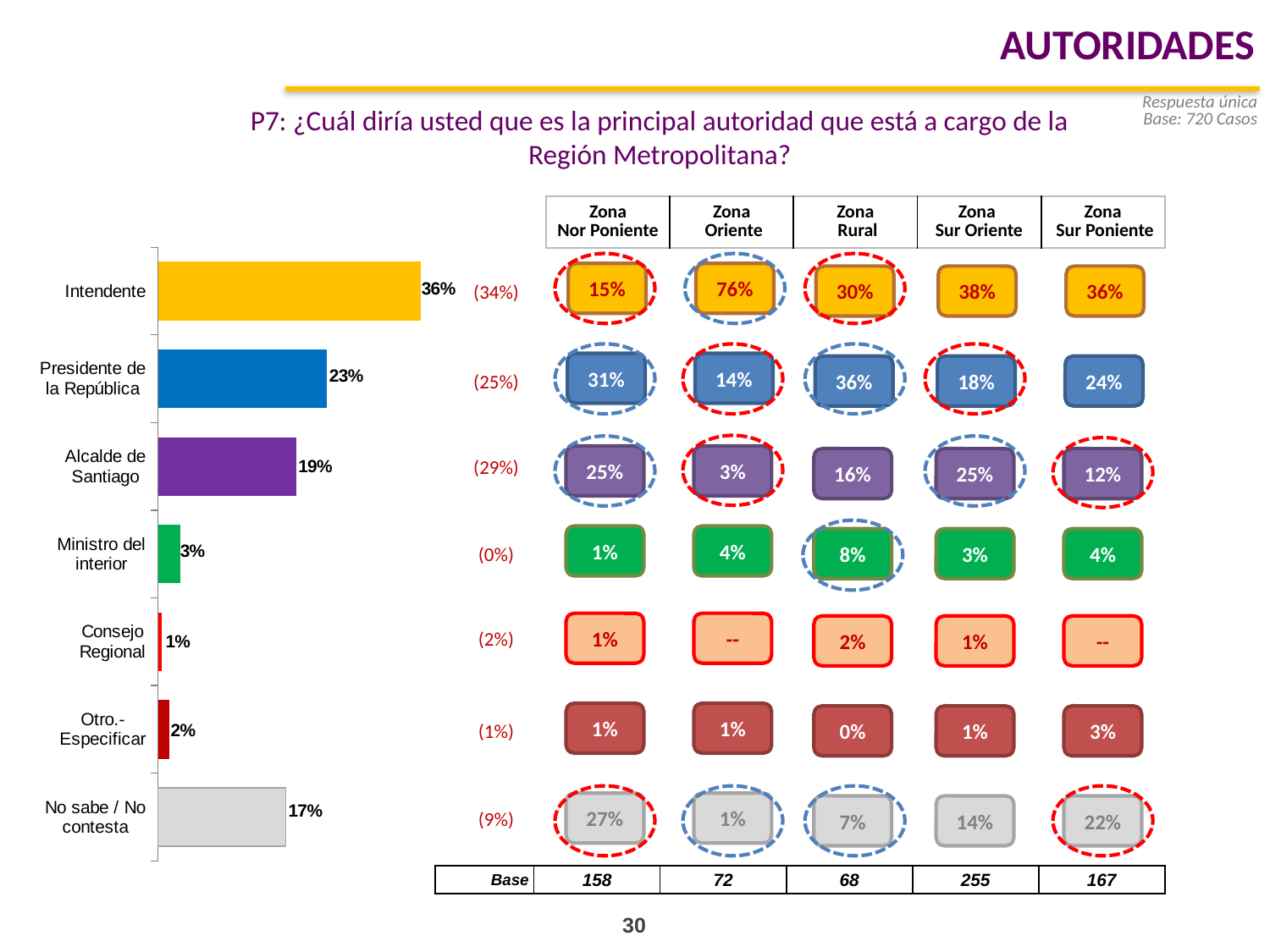
What percentage is shown for Intendente in the bar chart? 36% What percentage is shown for Presidente de la República in the bar chart? 23% What percentage is shown for No sabe / No contesta in the bar chart? 17% What colour is the bar for Alcalde de Santiago in the bar chart? Purple Which category has the highest value in the bar chart? Intendente Which is larger in the bar chart: Otro.-Especificar or Consejo Regional? Otro.-Especificar What percentage is shown for Ministro del interior in the bar chart? 3% Which category has the lowest value in the bar chart? Consejo Regional What is the difference between the values for Alcalde de Santiago and No sabe / No contesta in the bar chart? 2% How many categories are shown in the bar chart? 7 What type of chart is shown on the left of the slide? Bar chart What is the difference between the values for Intendente and Presidente de la República in the bar chart? 13%